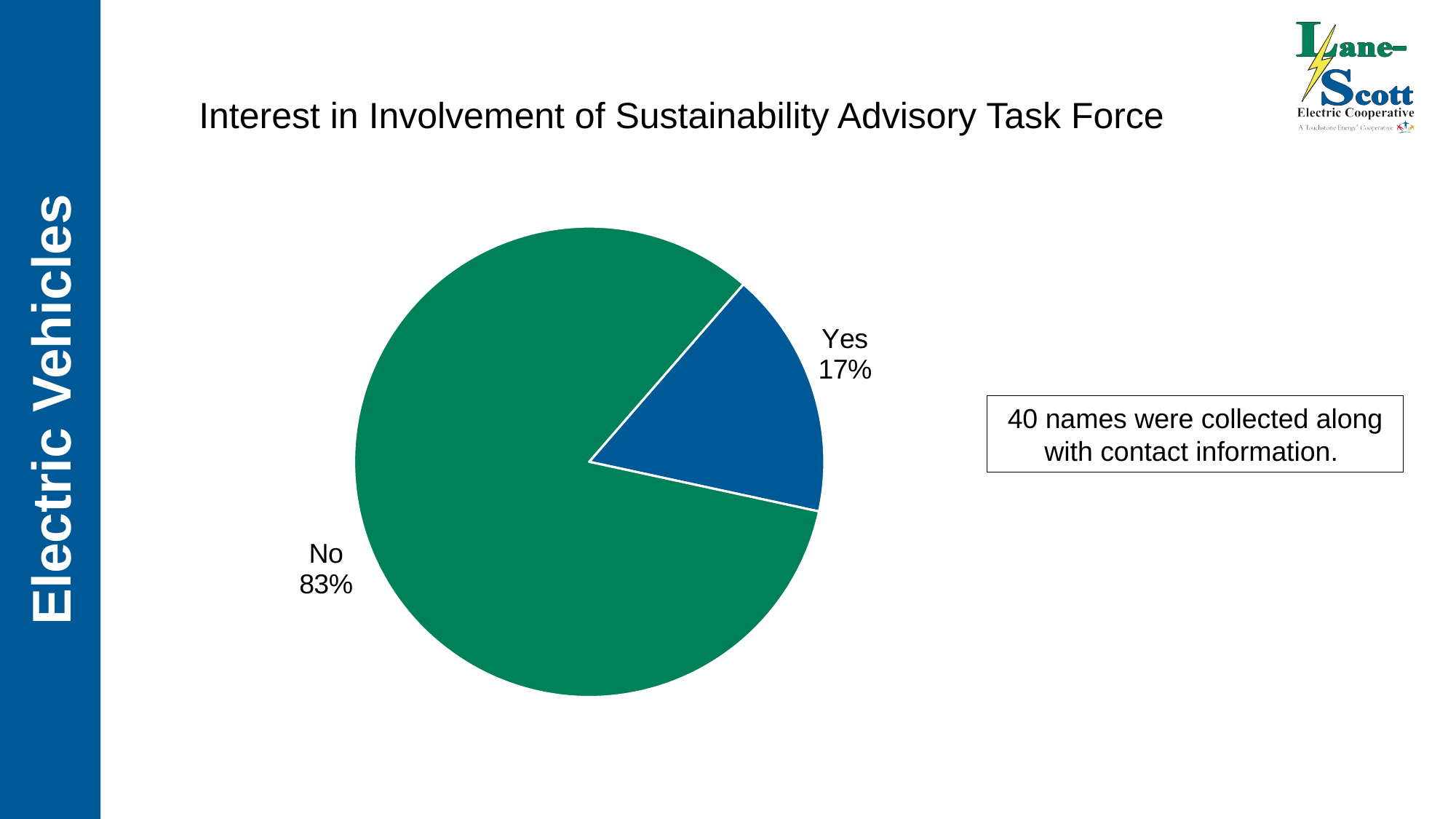
Which slice of the pie is the smallest? Yes What percentage of respondents answered "Yes"? 17% How many slices does the pie chart have? 2 What is the title of the chart? Interest in Involvement of Sustainability Advisory Task Force What colour is the "Yes" slice of the pie? blue Which is larger, the "Yes" slice or the "No" slice? No What is the difference in percentage points between the "No" and "Yes" slices? 66 What percentage of respondents answered "No"? 83% Which slice of the pie is the largest? No What share of the pie does the "Yes" slice represent? 17% What kind of chart is shown on the slide? pie chart